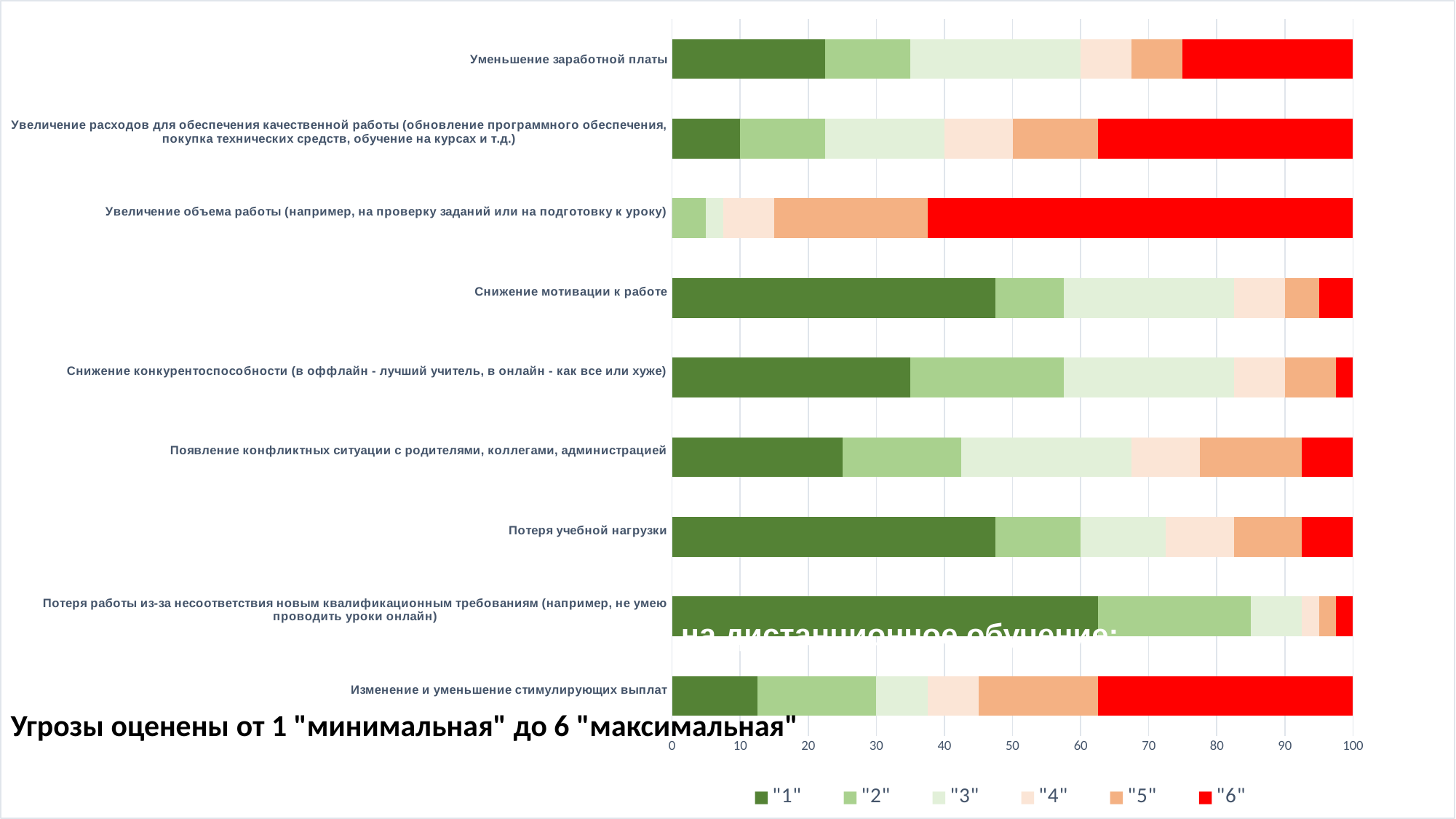
Is the share of series "1" for "Снижение мотивации к работе" greater or less than 50? less What kind of chart is shown on the slide? Stacked bar chart Which category has the largest share for series "6"? Увеличение объема работы (например, на проверку заданий или на подготовку к уроку) Which category has the largest share for series "1"? Потеря работы из-за несоответствия новым квалификационным требованиям (например, не умею проводить уроки онлайн) How many categories (threats) are plotted on the chart? 9 Is the share of series "1" for "Потеря работы из-за несоответствия новым квалификационным требованиям" greater or less than 60? greater Is the share of series "6" for "Увеличение объема работы" greater or less than 60? greater How many series does the legend list? 6 What colour represents the series "6" in the chart? Red What are the series names listed in the legend? "1", "2", "3", "4", "5", "6" What is the total of the stacked bar for "Уменьшение заработной платы"? 100 Which has the larger share of series "1": "Снижение мотивации к работе" or "Снижение конкурентоспособности"? Снижение мотивации к работе